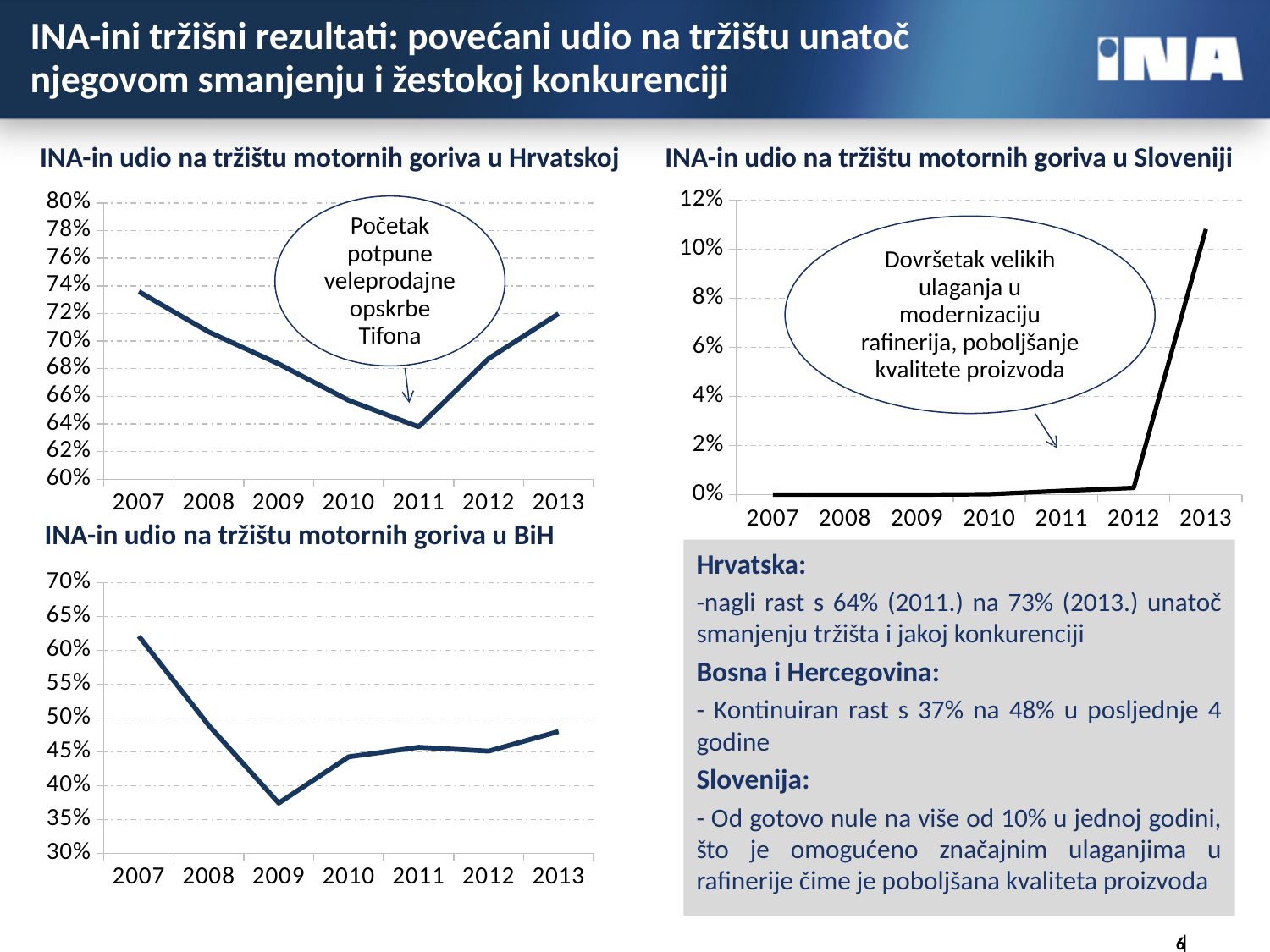
In the chart 'INA-in udio na tržištu motornih goriva u BiH', which is larger, the value for 2007 or the value for 2013? 2007 What kind of chart is 'INA-in udio na tržištu motornih goriva u Hrvatskoj'? line chart In the chart 'INA-in udio na tržištu motornih goriva u Sloveniji', which year has the highest market share? 2013 In the chart 'INA-in udio na tržištu motornih goriva u Hrvatskoj', is the value for 2011 greater or less than 66%? less In the chart 'INA-in udio na tržištu motornih goriva u BiH', which year has the lowest market share? 2009 In the chart 'INA-in udio na tržištu motornih goriva u BiH', do the values rise or fall from 2007 to 2009? fall In the chart 'INA-in udio na tržištu motornih goriva u Sloveniji', is the value for 2012 greater or less than 2%? less In the chart 'INA-in udio na tržištu motornih goriva u Hrvatskoj', do the values rise or fall from 2011 to 2013? rise In the chart 'INA-in udio na tržištu motornih goriva u Hrvatskoj', how many years are plotted on the x axis? 7 In the chart 'INA-in udio na tržištu motornih goriva u Hrvatskoj', is the value for 2007 greater or less than 72%? greater In the chart 'INA-in udio na tržištu motornih goriva u Hrvatskoj', which year has the lowest market share? 2011